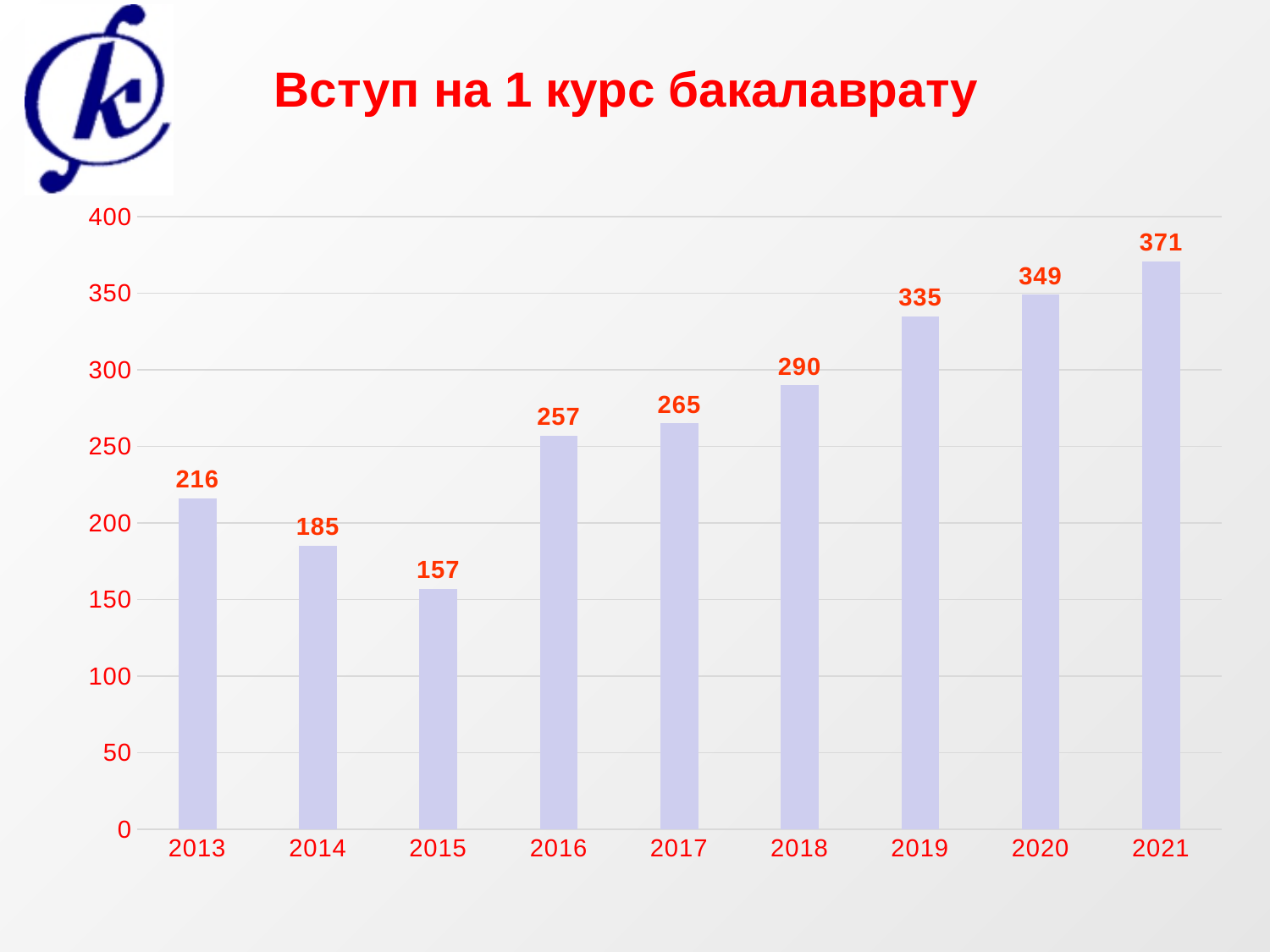
How many years are shown on the x axis? 9 Which year has the lowest value? 2015 Do the values rise or fall from 2015 to 2021? rise Is the value for 2019 greater or less than 300? greater What is the value for 2018? 290 What is the value for 2021? 371 Which year has the highest value? 2021 What is the difference between the values for 2021 and 2013? 155 What kind of chart is shown on the slide? bar chart What is the difference between the values for 2016 and 2015? 100 What is the value for 2013? 216 Which is larger, the value for 2014 or the value for 2017? 2017